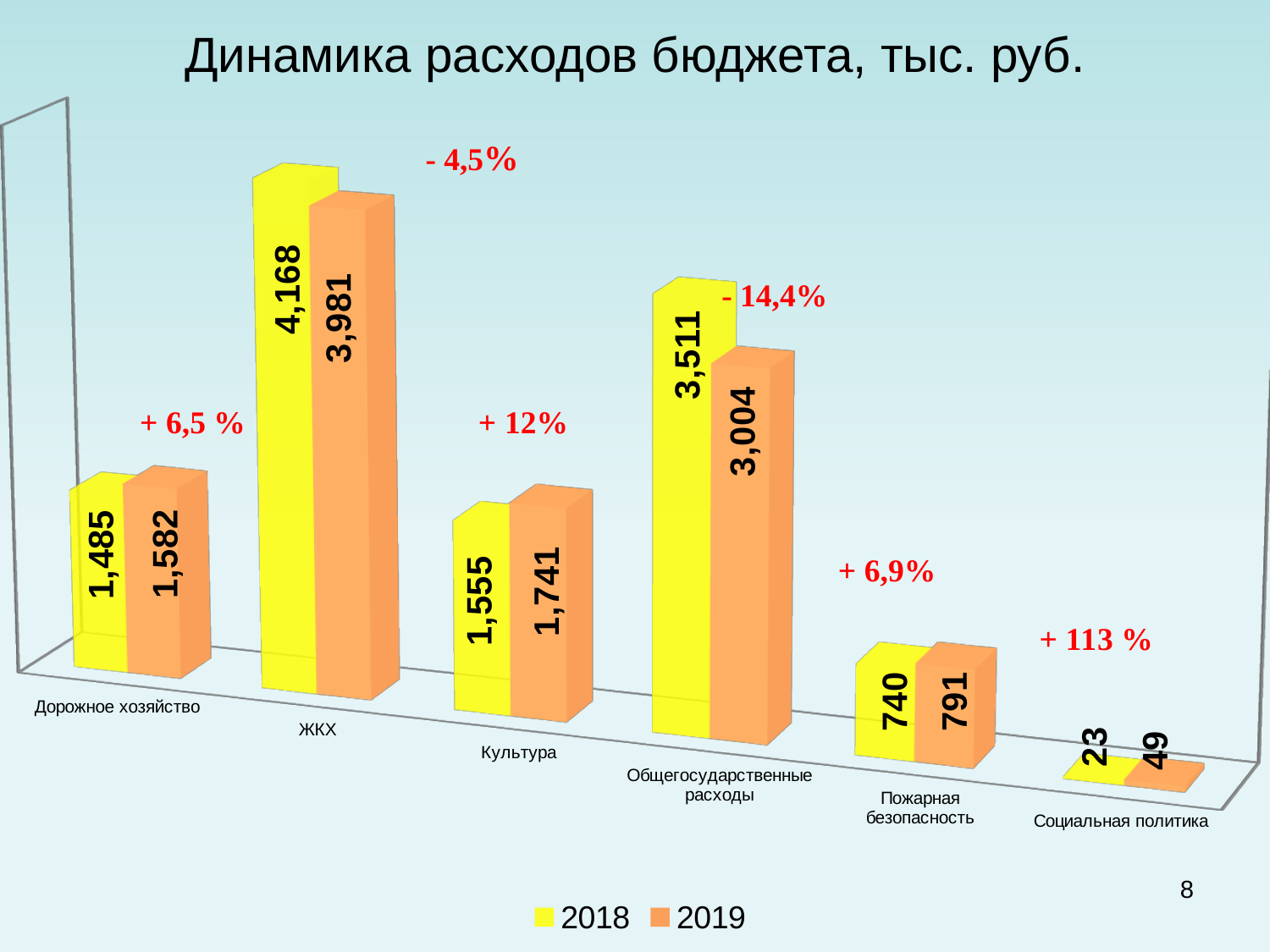
What is the 2019 value for Общегосударственные расходы? 3,004 What is the difference between the 2018 and 2019 values for Общегосударственные расходы? 507 How many categories are shown on the x axis? 6 What is the difference between the 2019 and 2018 values for Пожарная безопасность? 51 Which is larger for Культура: the 2018 value or the 2019 value? 2019 How many series does the legend list? 2 Which category has the lowest 2019 value? Социальная политика What is the 2018 value for ЖКХ? 4,168 What percentage change is shown above the bars for Социальная политика? + 113 % What is the 2019 value for Социальная политика? 49 What kind of chart is shown on the slide? Bar chart Which category has the highest 2018 value? ЖКХ